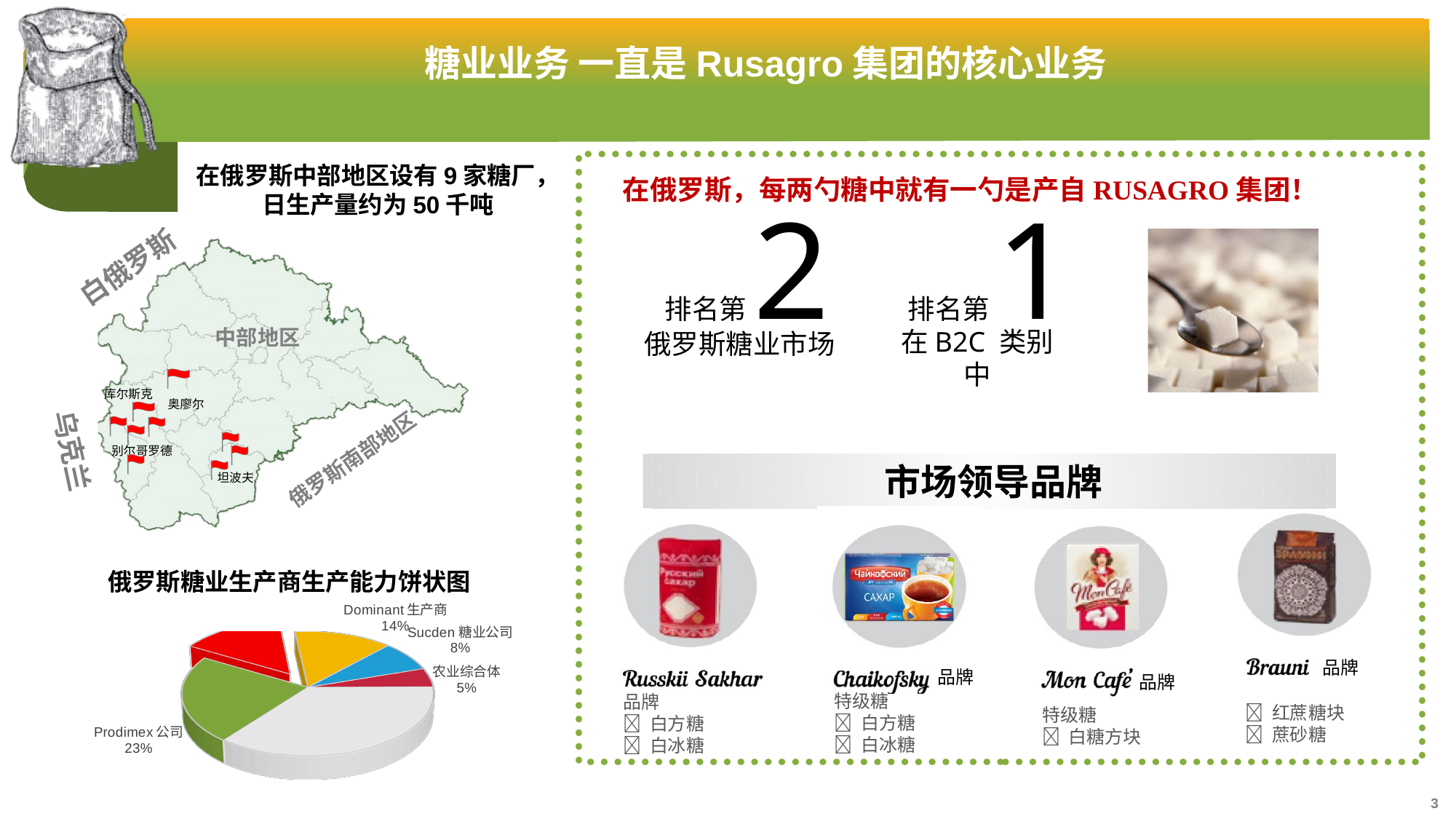
What share of the pie does Dominant 生产商 hold? 14% What share of the pie does 农业综合体 hold? 5% What is the title of the pie chart on the slide? 俄罗斯糖业生产商生产能力饼状图 What colour is the slice representing Prodimex 公司 in the pie chart? green What type of chart is shown at the bottom left of the slide? pie chart Which is larger in the pie chart: Dominant 生产商 or Sucden 糖业公司? Dominant 生产商 What is the difference in percentage points between Sucden 糖业公司 and 农业综合体? 3 How many percentage points larger is Prodimex 公司's share than Dominant 生产商's share? 9 What share of the pie does Prodimex 公司 hold? 23% How many slices does the pie chart have? 6 What share of the pie does Sucden 糖业公司 hold? 8% Which labeled slice of the pie chart is the smallest? 农业综合体